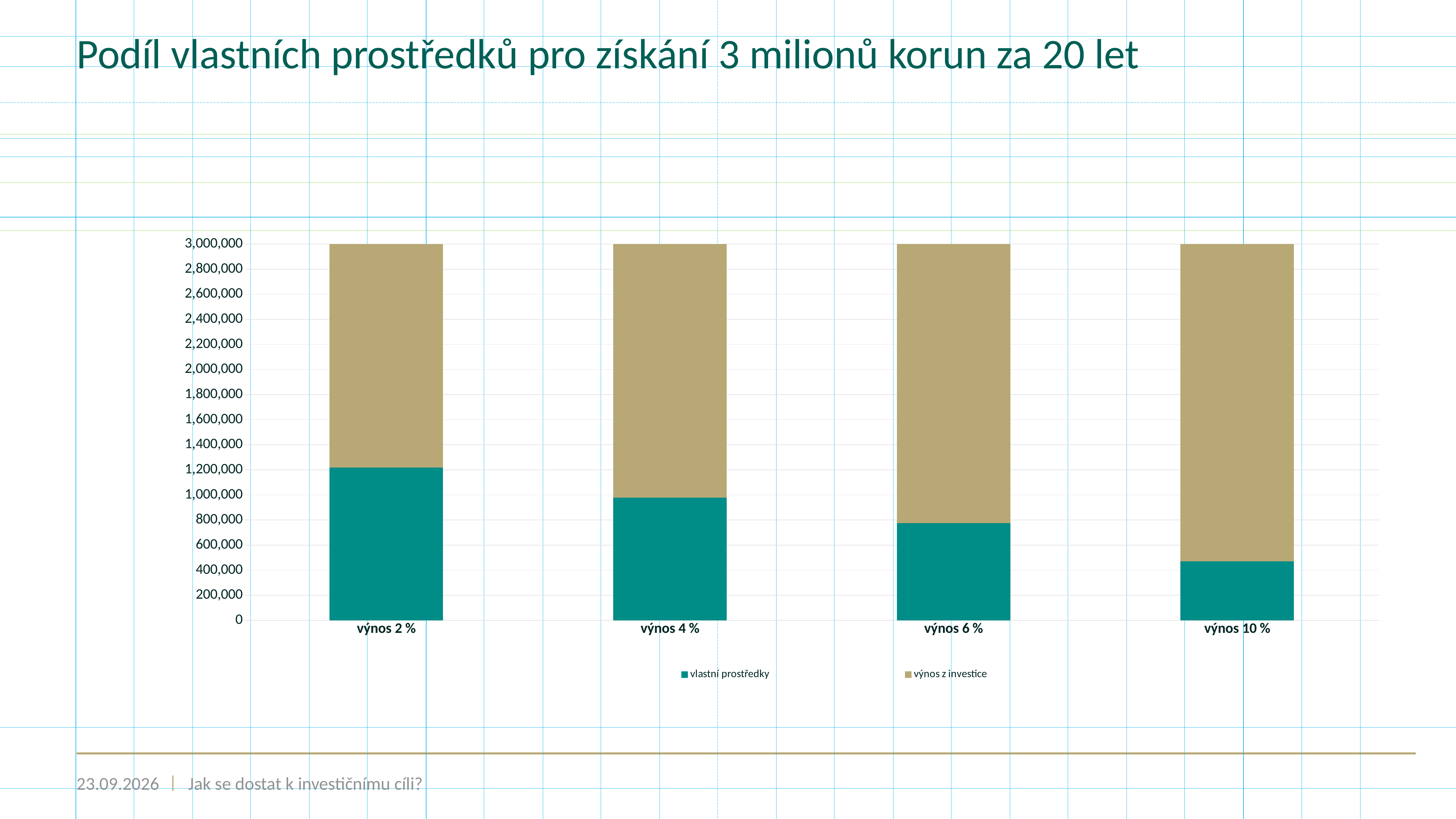
Do the vlastní prostředky values rise or fall from výnos 2 % to výnos 10 %? fall What kind of chart is shown on the slide? stacked bar chart Is the value of vlastní prostředky for výnos 6 % greater or less than 1,000,000? less How many series does the chart's legend list? 2 Is the value of vlastní prostředky for výnos 10 % greater or less than 600,000? less What is the total height of the stacked bar for výnos 10 %? 3,000,000 Which is larger, the vlastní prostředky value for výnos 4 % or for výnos 10 %? výnos 4 % What is the total height of the stacked bar for výnos 2 %? 3,000,000 How many categories are shown on the x axis of the chart? 4 Is the value of vlastní prostředky for výnos 2 % greater or less than 1,000,000? greater Which category has the lowest value for vlastní prostředky? výnos 10 % Which category has the highest value for vlastní prostředky? výnos 2 %